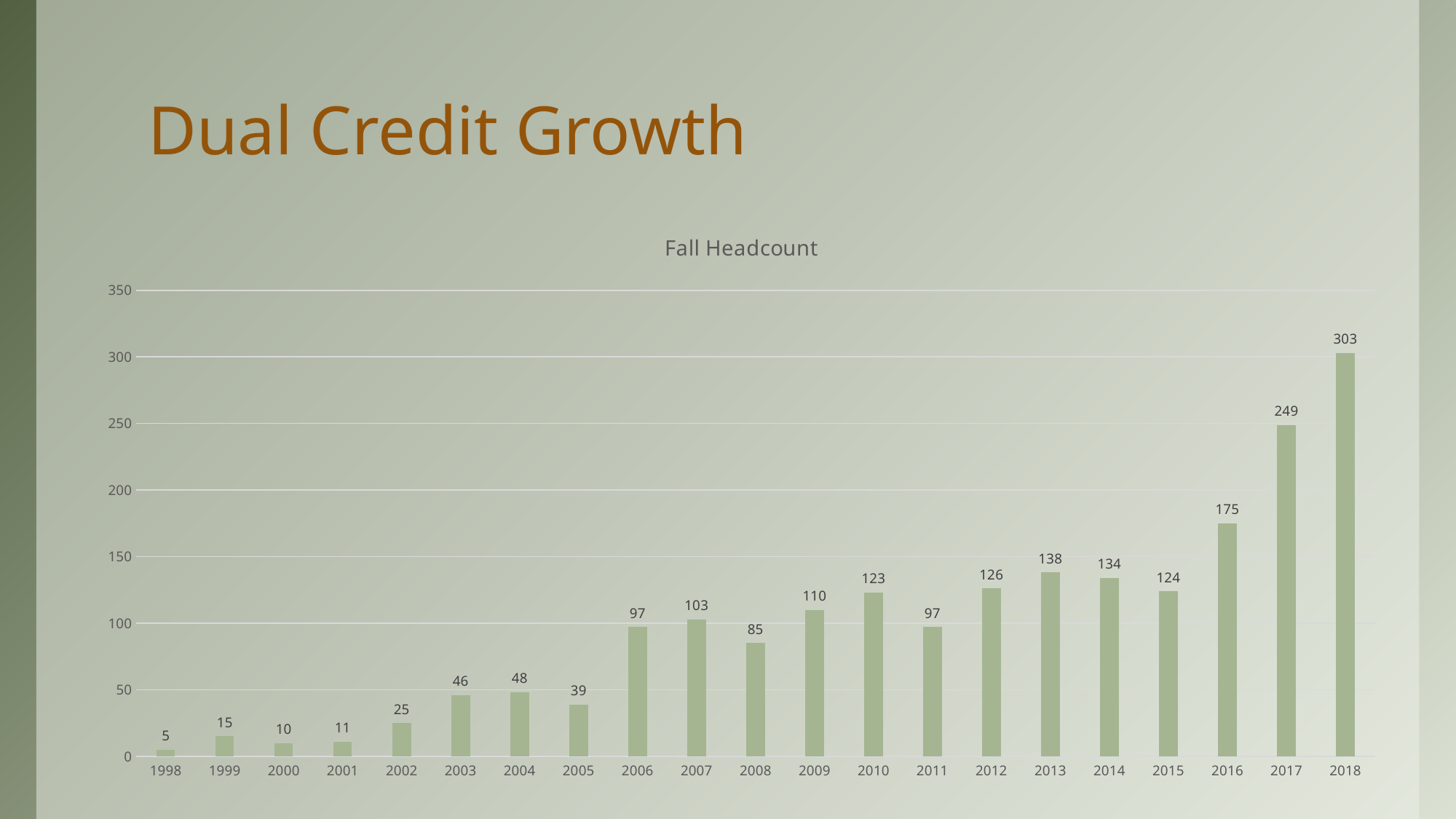
How many years are shown on the x axis of the chart? 21 What kind of chart is shown on the slide? Bar chart What is the Fall Headcount value for 2002? 25 What is the Fall Headcount value for 2018? 303 What is the Fall Headcount value for 2008? 85 Is the Fall Headcount value for 2017 greater or less than 200? greater Which year has the lowest Fall Headcount? 1998 What is the difference between the Fall Headcount in 2016 and in 2015? 51 What is the title of the chart? Fall Headcount Which year has the highest Fall Headcount? 2018 Which year has a larger Fall Headcount, 2013 or 2014? 2013 What is the difference between the Fall Headcount in 2018 and in 2017? 54